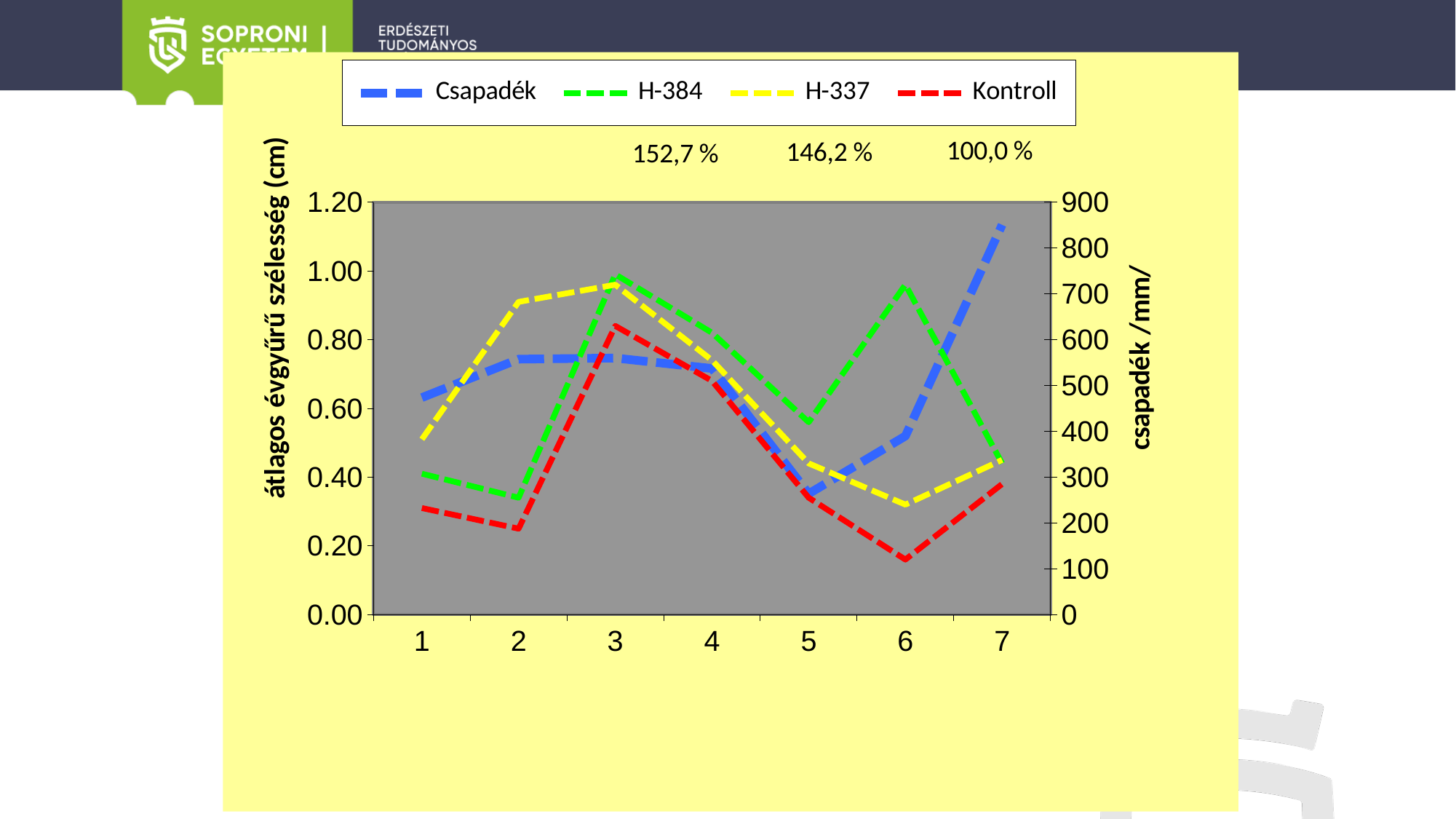
Does the Csapadék series rise or fall from point 6 to point 7? rise Is the H-337 value at point 3 greater or less than 0.80? greater At point 2, which is larger: H-337 or H-384? H-337 At which x-axis point is the Csapadék series lowest? 5 What is the label of the right-hand vertical axis? csapadék /mm/ Is the Kontroll value at point 6 greater or less than 0.20? less At which x-axis point is the Kontroll series lowest? 6 How many points are there along the x axis? 7 At which x-axis point is the Kontroll series highest? 3 How many series does the legend list? 4 What kind of chart is shown on the slide? line chart Is the Csapadék value at point 7 greater or less than 800? greater